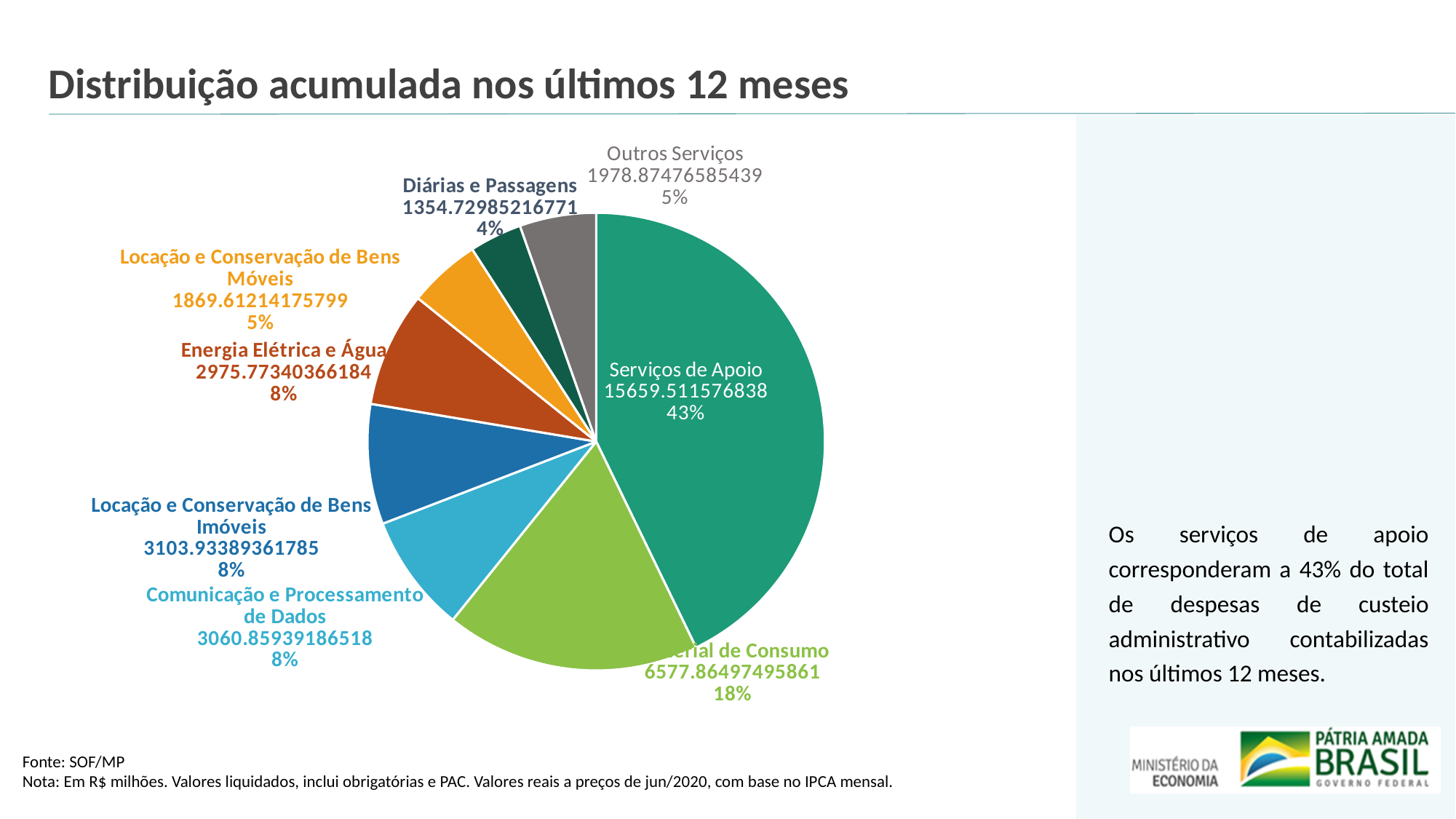
What is the value shown for Serviços de Apoio? 15659.511576838 Which category has the largest slice of the pie? Serviços de Apoio Which is larger, the value for Outros Serviços or the value for Locação e Conservação de Bens Móveis? Outros Serviços What share of the pie does Serviços de Apoio represent? 43% How many slices does the pie chart have? 8 What is the value shown for Diárias e Passagens? 1354.72985216771 What is the value shown for Energia Elétrica e Água? 2975.77340366184 What type of chart is shown on the slide? Pie chart What is the title of the chart on the slide? Distribuição acumulada nos últimos 12 meses What share of the pie does Material de Consumo represent? 18% What share of the pie does Comunicação e Processamento de Dados represent? 8% Which category has the smallest slice of the pie? Diárias e Passagens